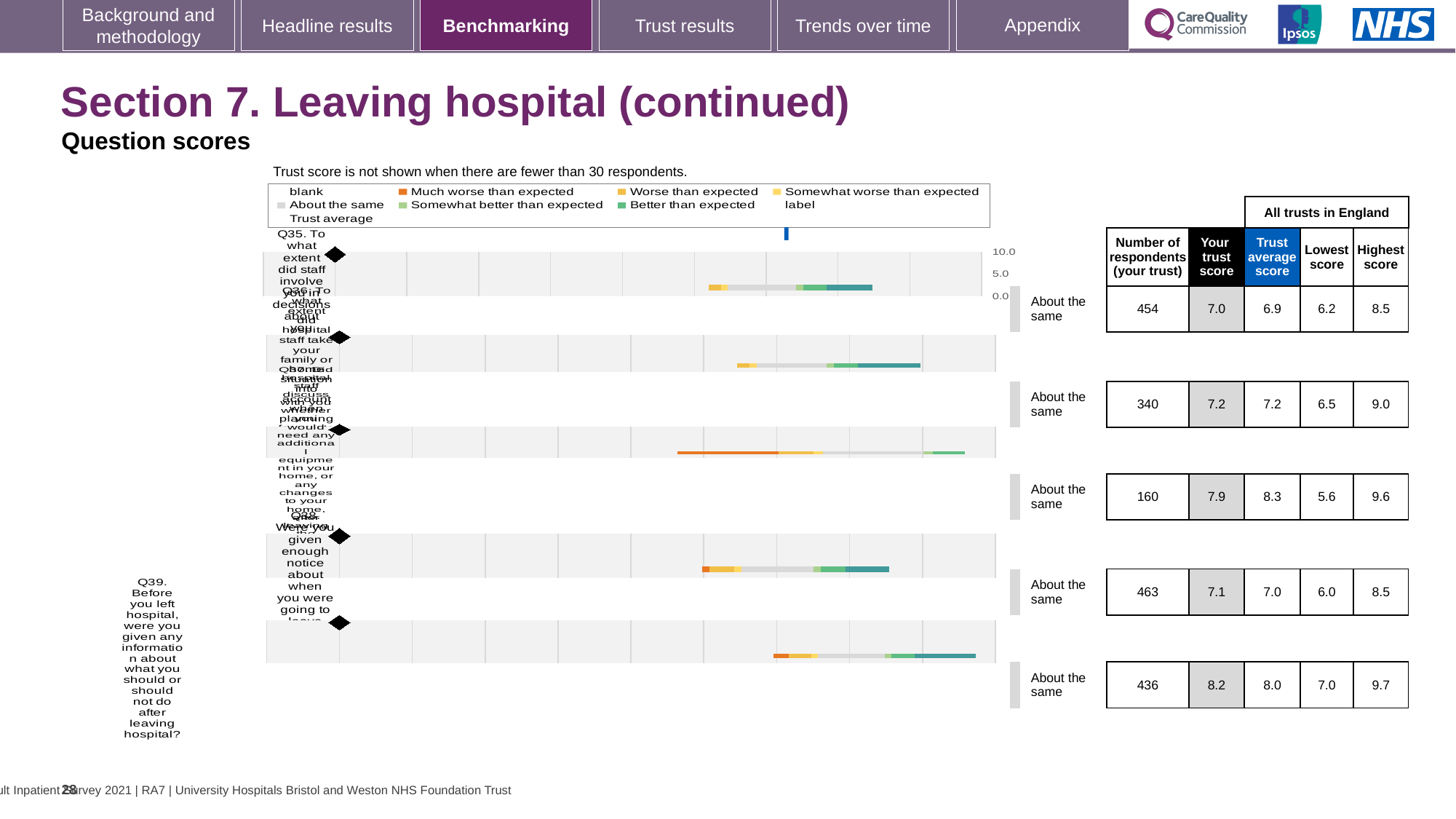
Which question has the fewest respondents from your trust? Q37 Which question has the highest 'Your trust score' on this slide? Q39 What is the trust average score for Q37? 8.3 How many respondents from your trust answered Q35 (To what extent did staff involve you in decisions about you leaving hospital)? 454 What is the highest score across all trusts in England for Q39 (Before you left hospital, were you given any information about what you should or should not do after leaving hospital)? 9.7 What is your trust score for Q36? 7.2 What is the difference between the trust average score and your trust score for Q37? 0.4 What is the lowest score across all trusts in England for Q38? 6.0 How many questions are plotted in the chart on this slide? 5 What benchmark category is shown for Q39 in the chart? About the same For Q35, which is larger: your trust score or the trust average score? Your trust score What type of chart is used to show the question scores on this slide? Bar chart